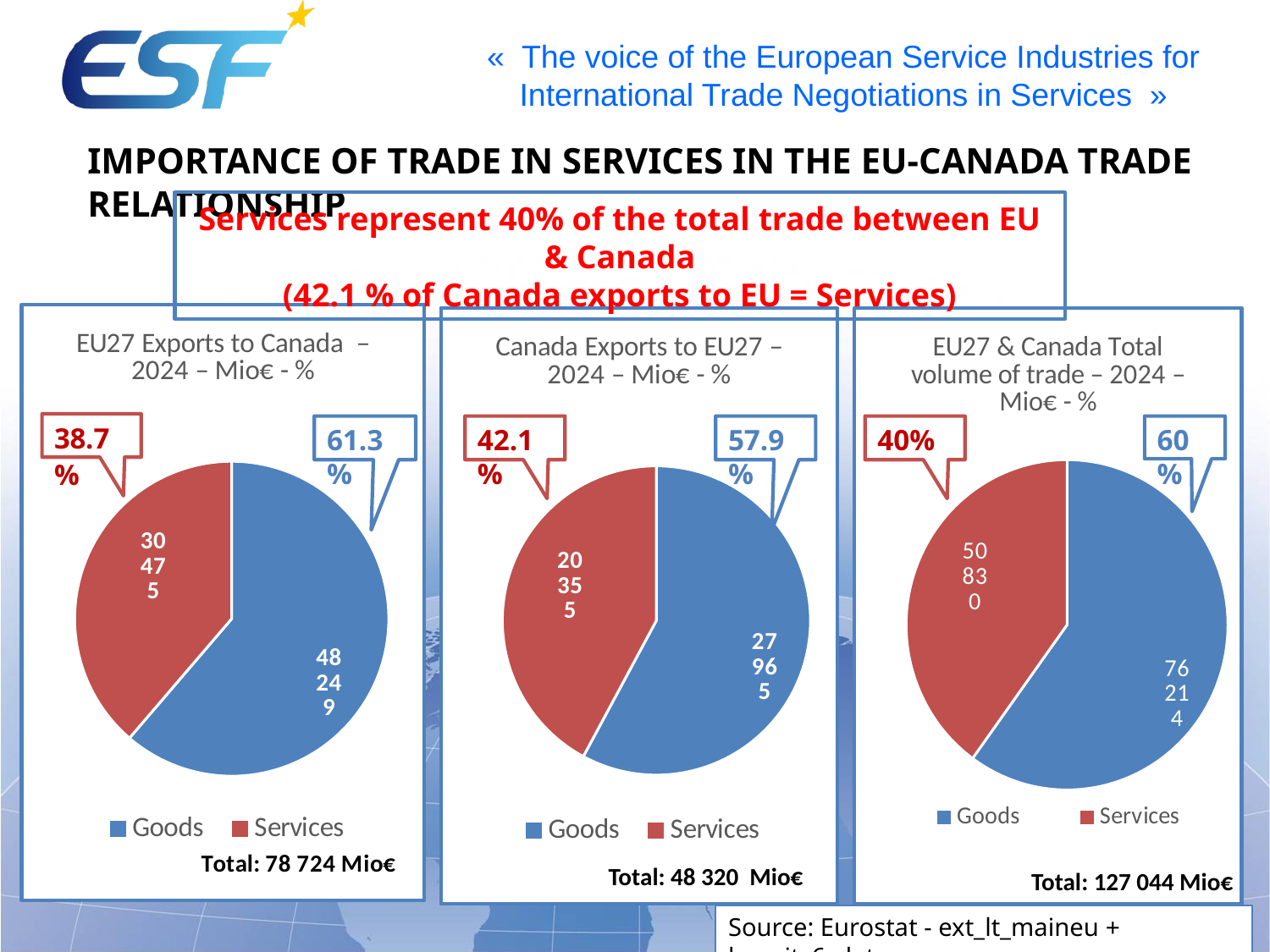
In the 'EU27 Exports to Canada' chart, what percentage share do Goods have? 61.3% What type of chart is used on this slide for the EU27 Exports to Canada data? Pie chart In the 'EU27 & Canada Total volume of trade' chart, what percentage share do Goods have? 60% In the 'EU27 & Canada Total volume of trade' chart, what is the total shown below the chart? 127 044 Mio€ In the 'Canada Exports to EU27' chart, what is the total shown below the chart? 48 320 Mio€ In the 'EU27 Exports to Canada' chart, what is the total shown below the chart? 78 724 Mio€ In the 'Canada Exports to EU27' chart, what percentage share do Services have? 42.1% In the 'EU27 & Canada Total volume of trade' chart, what is the value labelled on the Goods slice? 76 214 In the 'Canada Exports to EU27' chart, what colour represents Services? Red How many series does the legend list in the 'EU27 Exports to Canada' chart? 2 In the 'Canada Exports to EU27' chart, which slice is larger, Goods or Services? Goods